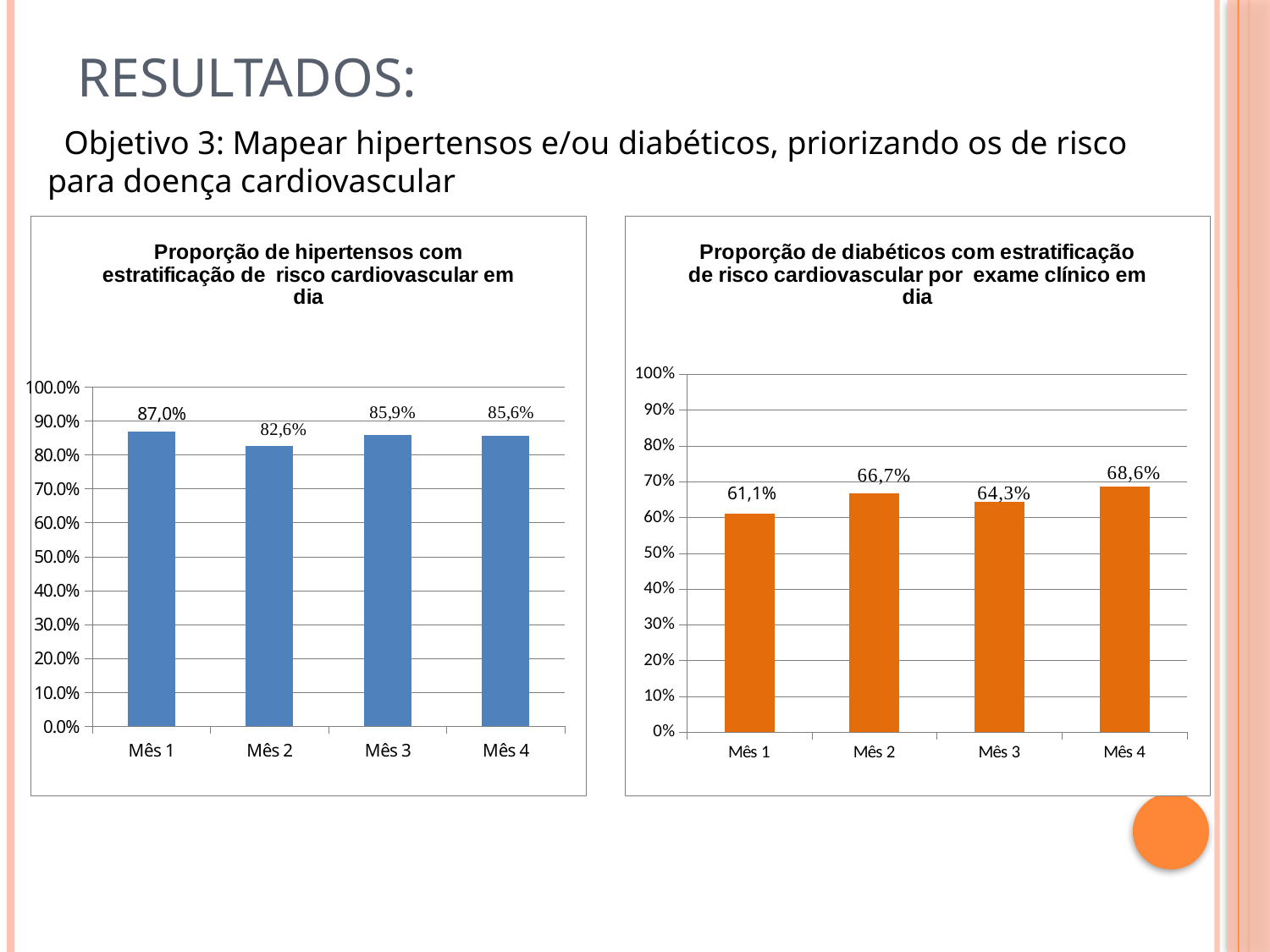
In the right chart (diabéticos), which month has the highest value? Mês 4 In the right chart (diabéticos), is the value for Mês 2 larger or smaller than the value for Mês 3? larger How many months are shown on the x axis of the right chart (diabéticos)? 4 In the right chart (diabéticos), which month has the lowest value? Mês 1 In the left chart (hipertensos), is the value for Mês 3 greater or less than 80.0%? greater In the left chart (hipertensos), what is the difference between the values for Mês 1 and Mês 2? 4,4 percentage points In the left chart (hipertensos), which month has the highest value? Mês 1 In the chart titled 'Proporção de hipertensos com estratificação de risco cardiovascular em dia', what is the value for Mês 2? 82,6% In the left chart (hipertensos), which month has the lowest value? Mês 2 In the chart titled 'Proporção de diabéticos com estratificação de risco cardiovascular por exame clínico em dia', what is the value for Mês 4? 68,6% In the right chart (diabéticos), what is the difference between the values for Mês 4 and Mês 1? 7,5 percentage points What type of chart is the left chart (hipertensos)? Bar chart